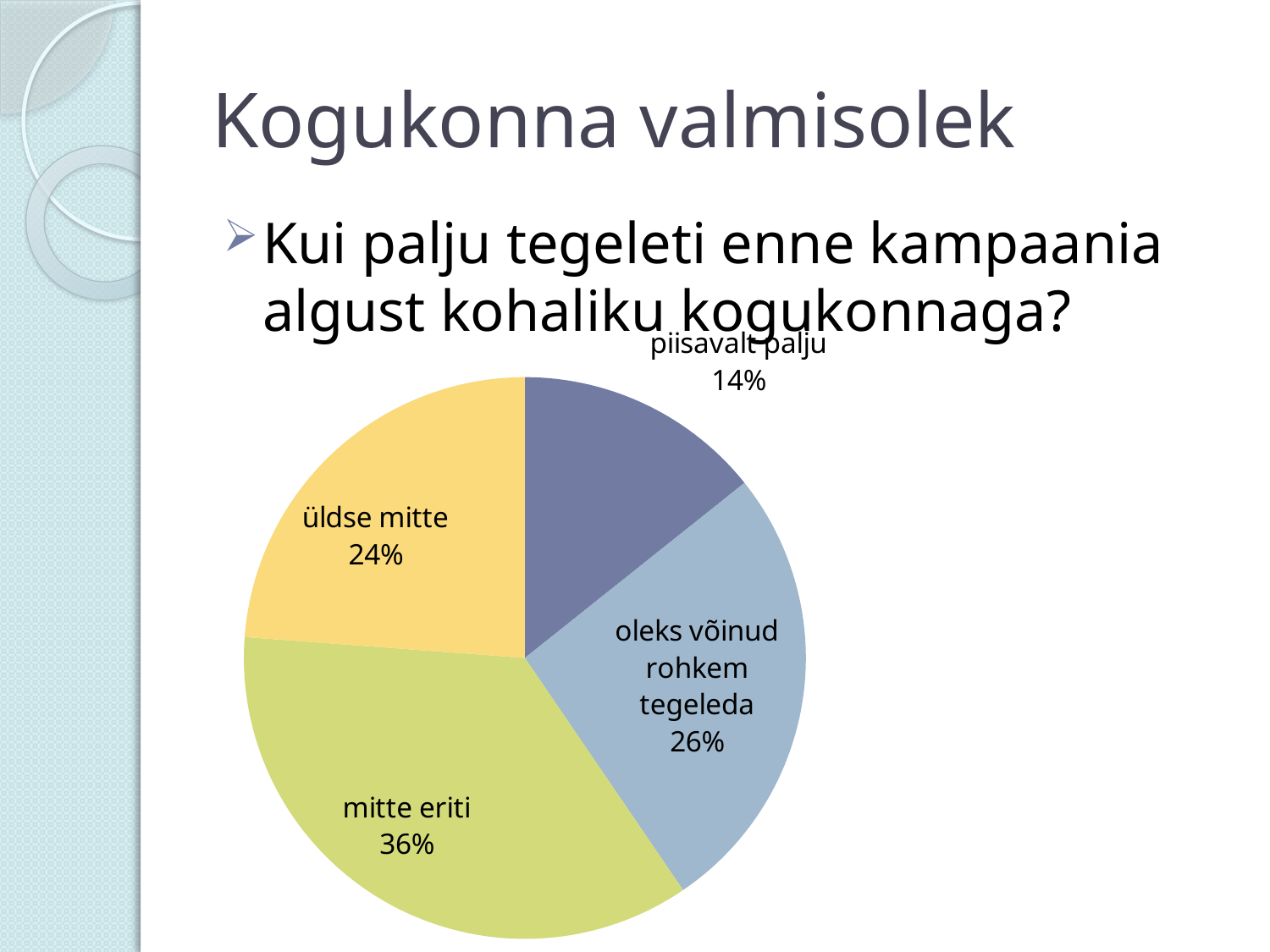
What is the difference between the shares of "oleks võinud rohkem tegeleda" and "piisavalt palju"? 12% Which slice of the pie is the smallest? piisavalt palju Which slice of the pie is the largest? mitte eriti What kind of chart is shown on the slide? pie chart Which is larger, the share for "oleks võinud rohkem tegeleda" or the share for "piisavalt palju"? oleks võinud rohkem tegeleda What is the value shown for "oleks võinud rohkem tegeleda"? 26% What is the value shown for "üldse mitte"? 24% What share of the pie does "mitte eriti" have? 36% What is the difference between the shares of "mitte eriti" and "üldse mitte"? 12% How many slices does the pie chart have? 4 What share of the pie does "piisavalt palju" have? 14% What colour is the "mitte eriti" slice? green